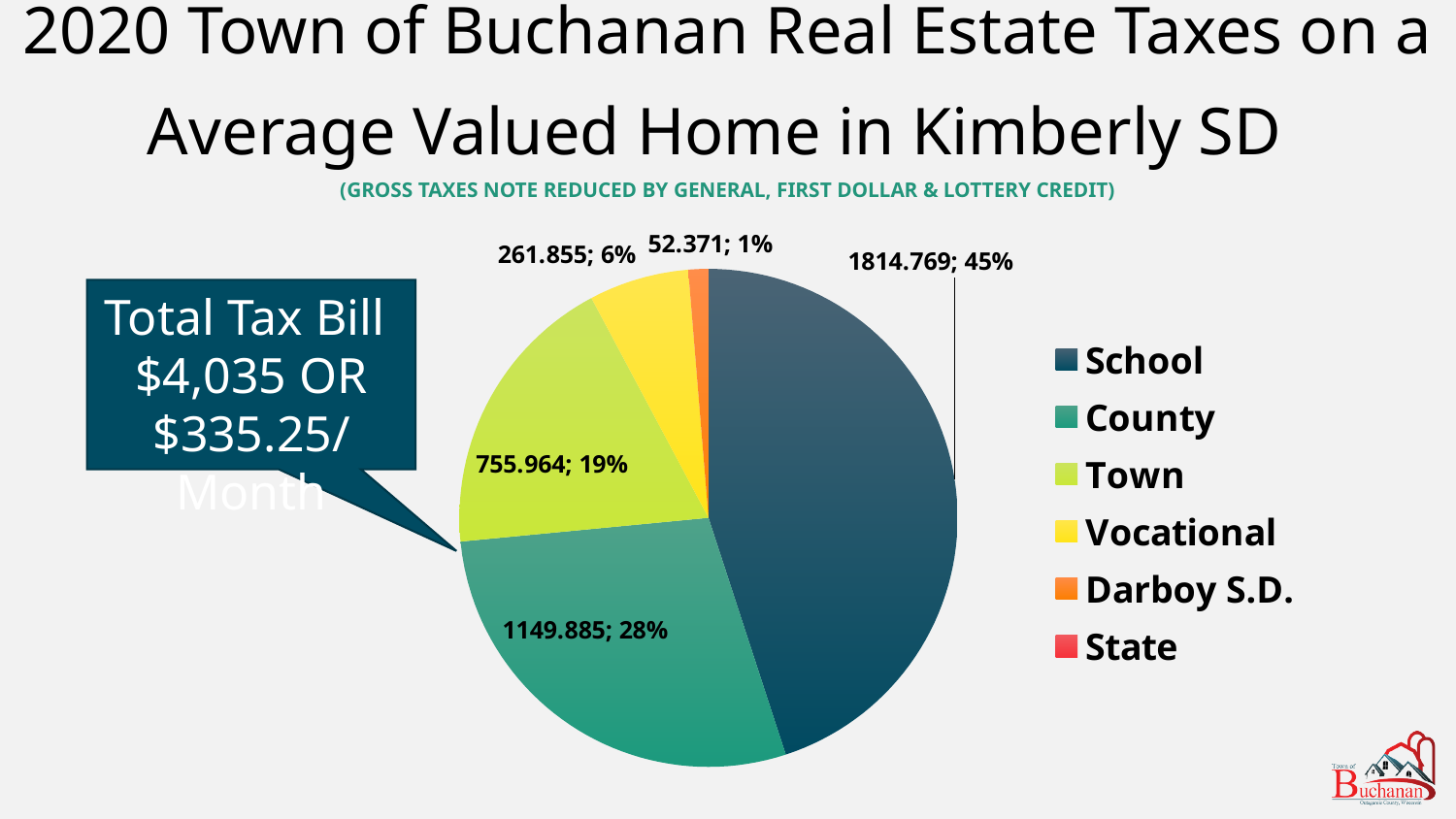
What value is shown for the County slice of the pie chart? 1149.885 How many entries does the legend of the pie chart list? 6 What percentage share of the pie does the School slice represent? 45% What value is shown for the Vocational slice of the pie chart? 261.855 Which category has the largest slice of the pie chart? School What value is shown for the School slice of the pie chart? 1814.769 What value is shown for the Town slice of the pie chart? 755.964 Which of the two is larger in the pie chart, County or Vocational? County What percentage share of the pie does the Town slice represent? 19% What is the difference between the School value and the County value in the pie chart? 664.884 What value is shown for the Darboy S.D. slice of the pie chart? 52.371 What kind of chart is shown on the slide? pie chart